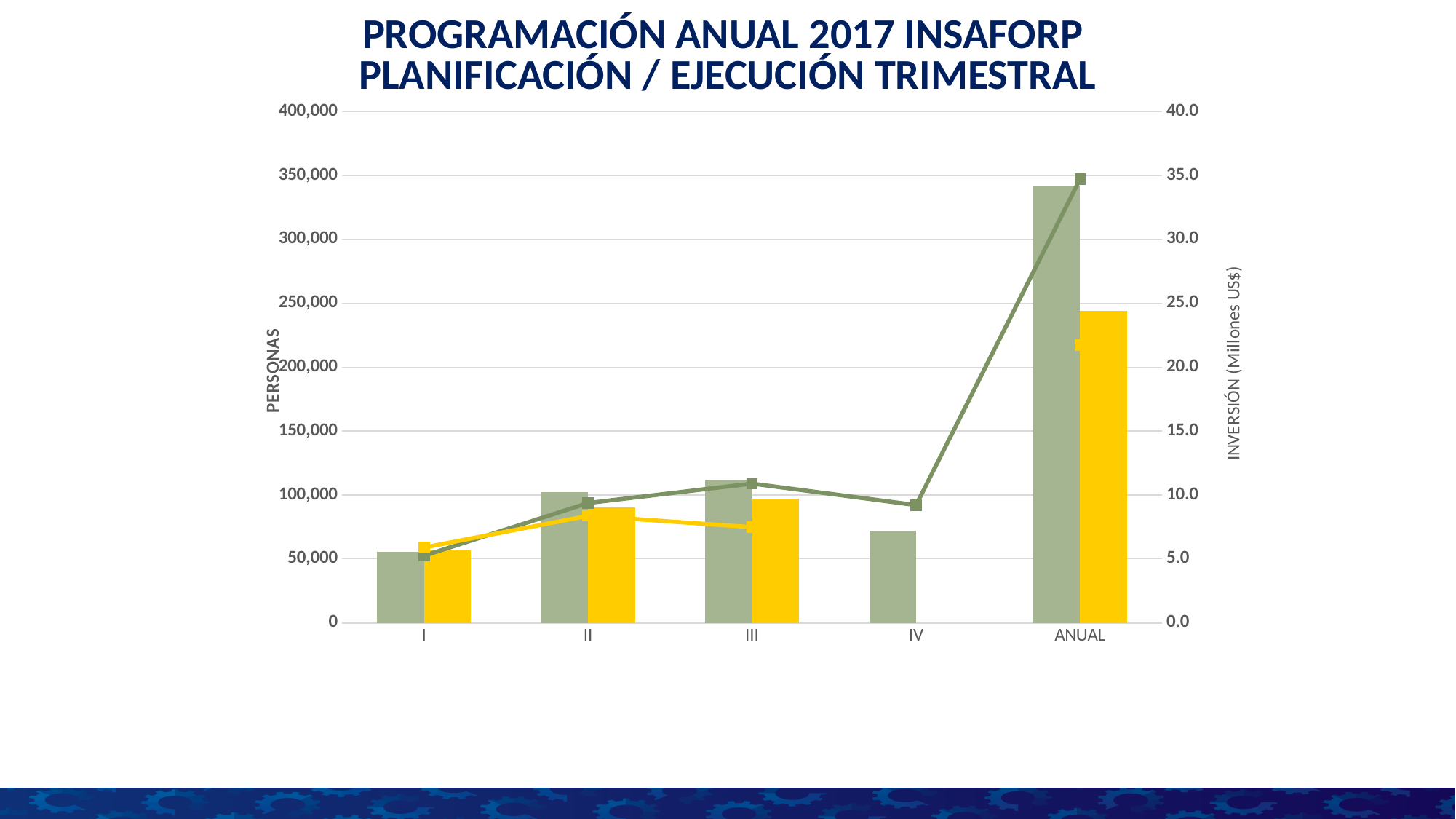
Is the green line value for ANUAL on the right axis greater or less than 30.0? greater Is the yellow bar for ANUAL greater or less than 250,000? less Which category has the tallest green bar? ANUAL Which is larger, the green bar for II or the green bar for IV? II What is the title of the right vertical axis? INVERSIÓN (Millones US$) What is the title of the left vertical axis? PERSONAS What kind of chart is shown on the slide? A combination bar and line chart Which category has the shortest green bar? I Is the green bar for ANUAL greater or less than 300,000? greater How many categories are shown on the x axis? 5 Do the green bars rise or fall from I to III? rise